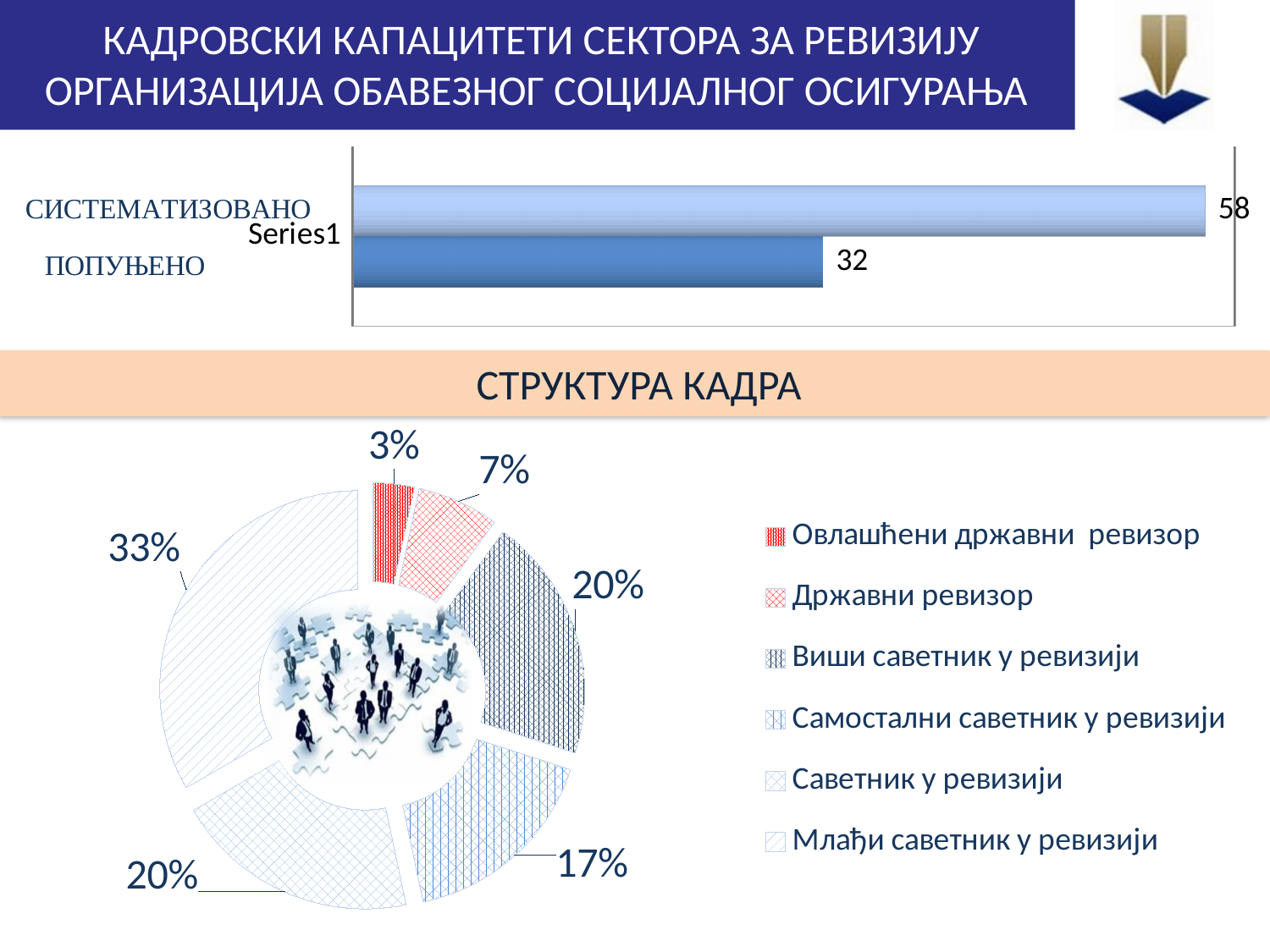
In the top bar chart, what is the value for ПОПУЊЕНО? 32 What kind of chart is the top chart on the slide? Bar chart In the top bar chart, what is the value for СИСТЕМАТИЗОВАНО? 58 In the СТРУКТУРА КАДРА chart, which category has the largest share? Млађи саветник у ревизији In the top bar chart, what is the difference between СИСТЕМАТИЗОВАНО and ПОПУЊЕНО? 26 In the СТРУКТУРА КАДРА chart, which category has the smallest share? Овлашћени државни ревизор In the СТРУКТУРА КАДРА chart, what share does Овлашћени државни ревизор have? 3% In the СТРУКТУРА КАДРА chart, what share does Самостални саветник у ревизији have? 17% How many categories does the legend of the СТРУКТУРА КАДРА chart list? 6 In the СТРУКТУРА КАДРА chart, what share does Млађи саветник у ревизији have? 33% In the СТРУКТУРА КАДРА chart, what is the difference between the shares of Државни ревизор and Овлашћени државни ревизор? 4% In the top bar chart, which is larger, СИСТЕМАТИЗОВАНО or ПОПУЊЕНО? СИСТЕМАТИЗОВАНО